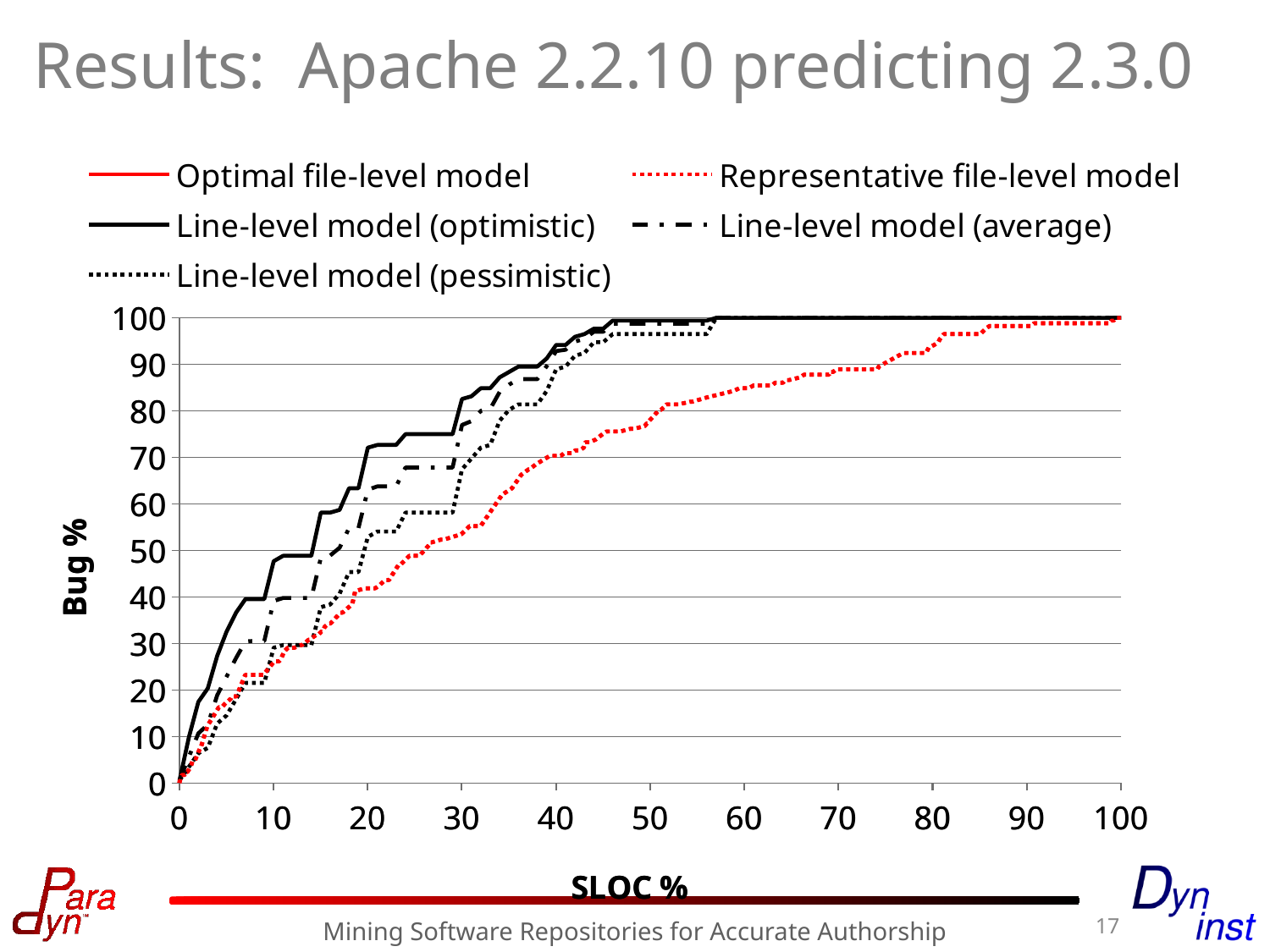
What is the label of the y axis? Bug % How many series does the legend list? 5 Which series has the lowest Bug % at 60 SLOC %? Representative file-level model At 30 SLOC %, which is higher: the Line-level model (optimistic) or the Representative file-level model? Line-level model (optimistic) Do the values of the Line-level model (optimistic) series rise or fall as SLOC % increases? rise Which series has the highest Bug % at 20 SLOC %? Line-level model (optimistic) Is the value of the Representative file-level model at 30 SLOC % greater or less than 50? greater Is the value of the Line-level model (pessimistic) at 30 SLOC % greater or less than 50? greater What is the label of the x axis? SLOC % Is the value of the Representative file-level model at 60 SLOC % greater or less than 80? greater What kind of chart is shown on the slide? line chart